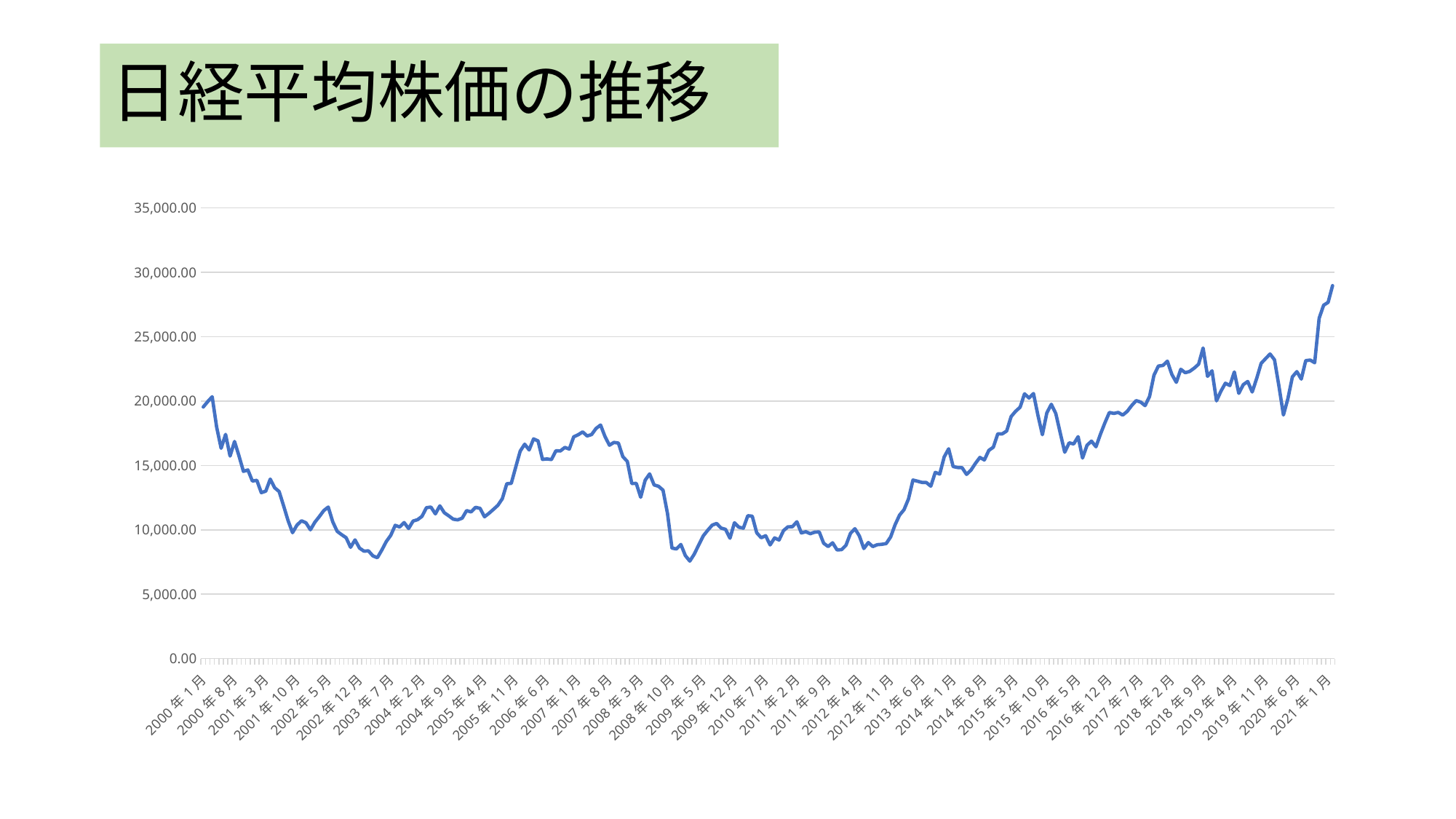
Which is larger, the value for 2007年8月 or the value for 2009年5月? 2007年8月 Is the value for 2007年8月 greater or less than 15,000? greater What is the highest value shown on the vertical axis? 35,000.00 Which is larger, the value for 2021年1月 or the value for 2000年1月? 2021年1月 Does the line rise or fall between 2007年8月 and 2008年10月? fall Is the value for 2018年9月 greater or less than 20,000? greater Is the value for 2002年12月 greater or less than 10,000? less What is the title of the chart? 日経平均株価の推移 What kind of chart is shown on the slide? line chart Does the line rise or fall between 2012年11月 and 2015年3月? rise